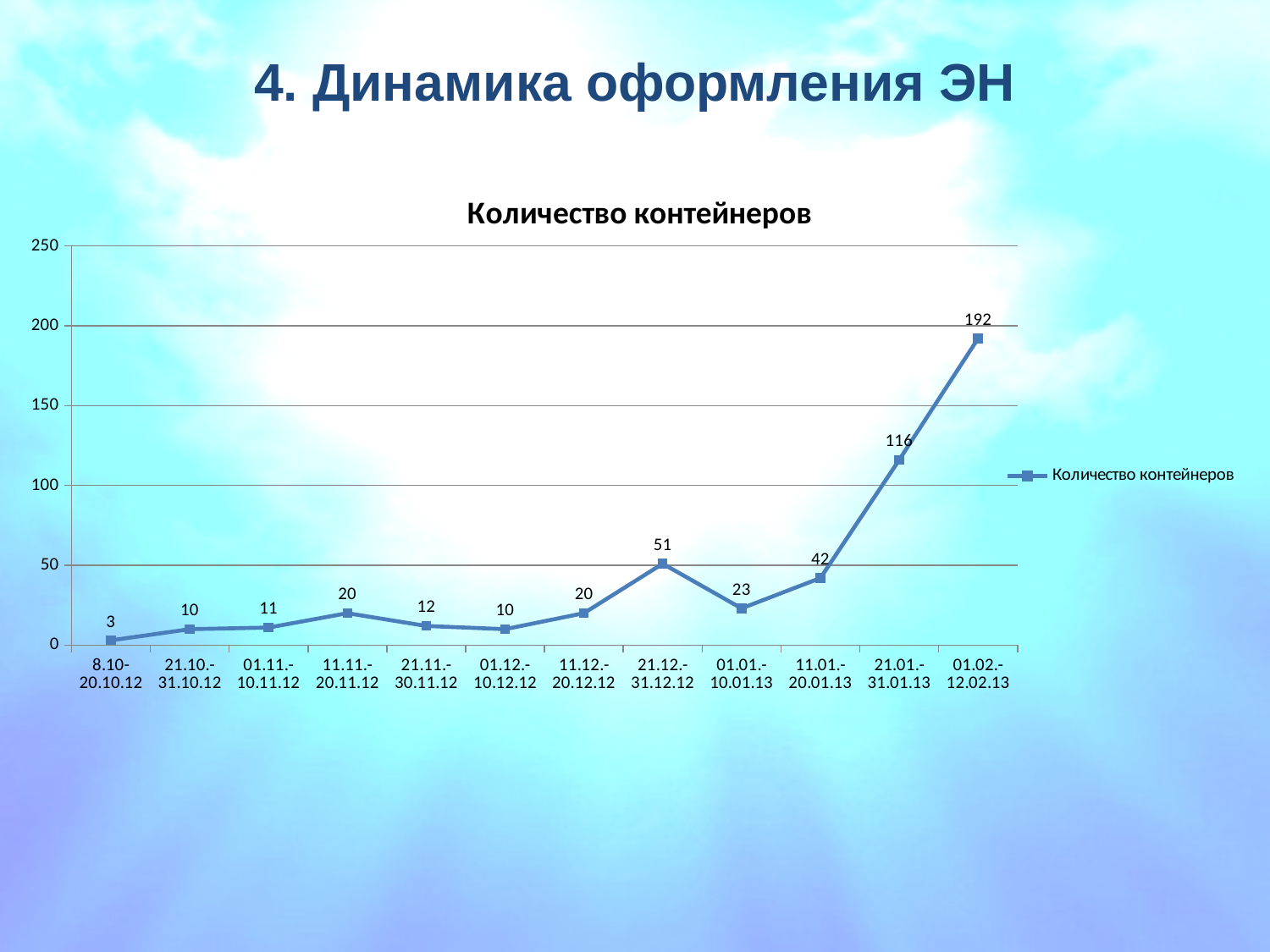
Which is larger, the value for 21.12.-31.12.12 or the value for 01.01.-10.01.13? 21.12.-31.12.12 What is the value for the period 01.02.-12.02.13? 192 What is the title of the chart? Количество контейнеров What is the value for the period 8.10-20.10.12? 3 Which period has the lowest number of containers? 8.10-20.10.12 How many series does the legend list? 1 What is the value for the period 21.12.-31.12.12? 51 How many periods are plotted on the x axis? 12 What is the difference between the values for 01.02.-12.02.13 and 21.01.-31.01.13? 76 What kind of chart is shown on the slide? line chart Is the value for 21.01.-31.01.13 greater or less than 100? greater Which period has the highest number of containers? 01.02.-12.02.13